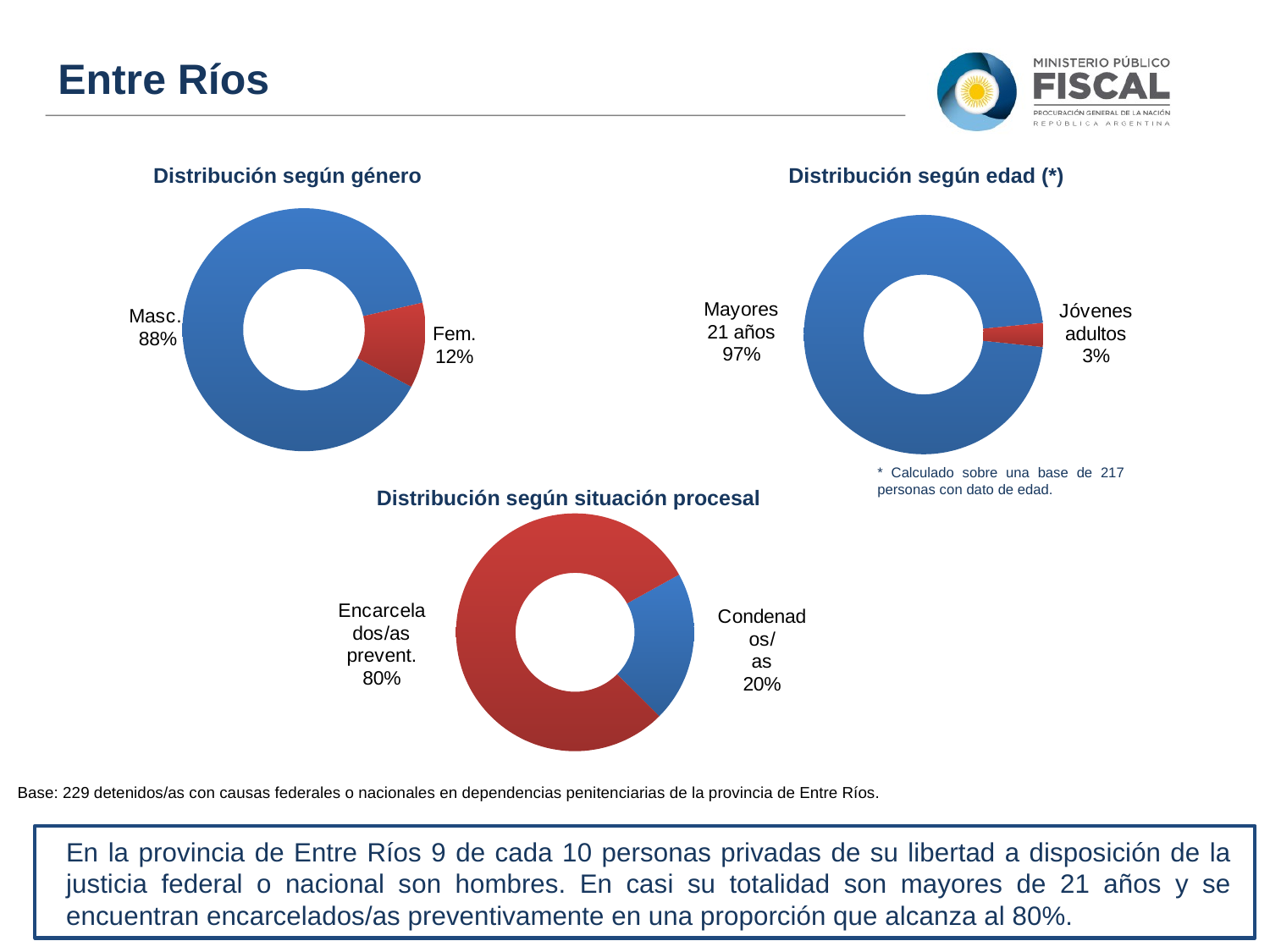
In the 'Distribución según género' chart, which category has the largest share? Masc. In the 'Distribución según género' chart, what share is labelled for Fem.? 12% How many categories does the 'Distribución según situación procesal' chart show? 2 In the 'Distribución según género' chart, what share is labelled for Masc.? 88% In the 'Distribución según situación procesal' chart, what share is labelled for Encarcelados/as prevent.? 80% In the 'Distribución según edad (*)' chart, what share is labelled for Jóvenes adultos? 3% In the 'Distribución según situación procesal' chart, what is the difference in percentage points between Encarcelados/as prevent. and Condenados/as? 60 In the 'Distribución según edad (*)' chart, which category has the smallest share? Jóvenes adultos What kind of chart is 'Distribución según edad (*)'? Doughnut (pie) chart In the 'Distribución según situación procesal' chart, what share is labelled for Condenados/as? 20% In the 'Distribución según género' chart, which is larger, Masc. or Fem.? Masc. In the 'Distribución según edad (*)' chart, what share is labelled for Mayores 21 años? 97%